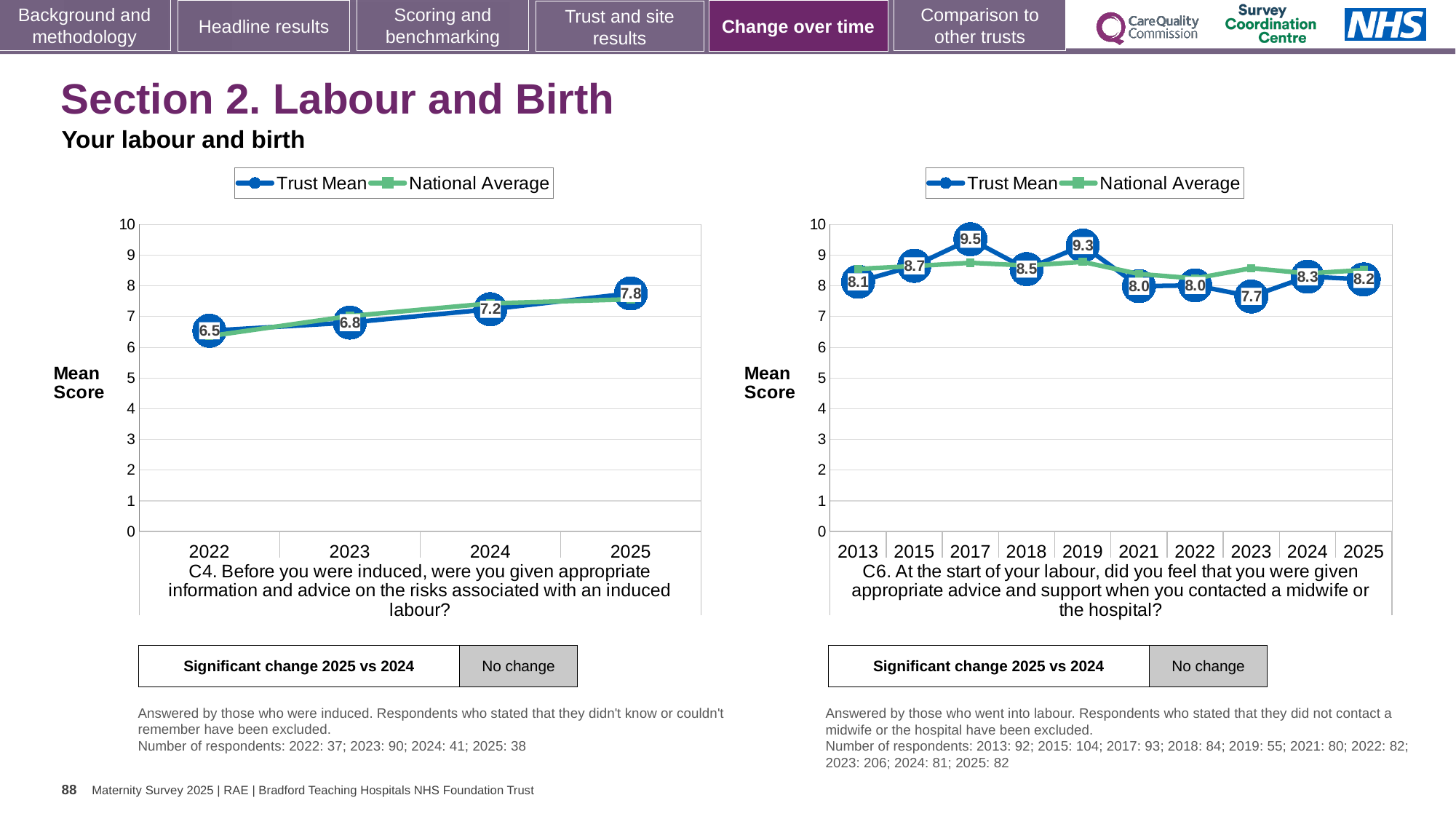
How many series does the legend of the C4 chart on the left list? 2 In the C6 chart on the right, which year has the lowest Trust Mean? 2023 In the C6 chart on the right, what is the Trust Mean for 2019? 9.3 In the C4 chart on the left, by how much did the Trust Mean increase from 2022 to 2025? 1.3 In the C4 chart on the left, what is the Trust Mean for 2025? 7.8 In the C4 chart on the left, what is the Trust Mean for 2022? 6.5 How many years are shown on the x axis of the C6 chart on the right? 10 How many years are shown on the x axis of the C4 chart on the left? 4 In the C6 chart on the right, is the Trust Mean higher in 2015 or in 2024? 2015 In the C6 chart on the right, which year has the highest Trust Mean? 2017 In the C4 chart on the left, does the Trust Mean rise or fall from 2022 to 2025? rise In the C6 chart on the right, what is the difference between the Trust Mean in 2017 and in 2018? 1.0